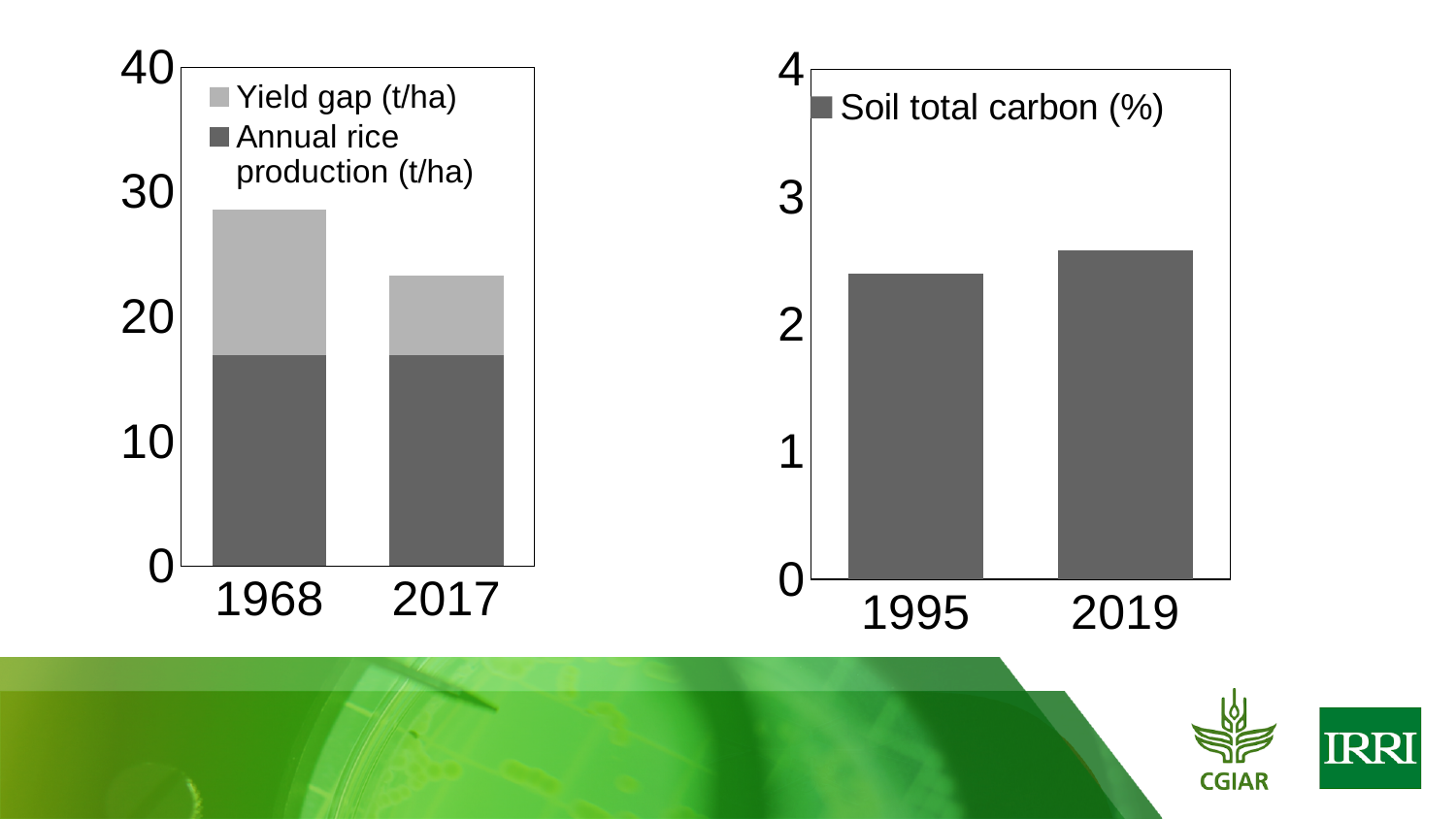
In the left chart, which year has the taller stacked bar, 1968 or 2017? 1968 In the left chart, is the total stacked value for 1968 greater or less than 20? greater How many series does the legend of the left chart list? 2 In the left chart, is the Yield gap (t/ha) segment for 2017 greater or less than 10? less In the right chart, does Soil total carbon (%) rise or fall from 1995 to 2019? rise What kind of chart is the left chart with the years 1968 and 2017? stacked bar chart What kind of chart is the right chart showing Soil total carbon (%)? bar chart In the left chart, which series is shown in the lighter grey colour? Yield gap (t/ha) How many categories are shown on the x axis of the right chart? 2 In the right chart, is the Soil total carbon (%) value for 1995 greater or less than 3? less In the right chart, which year has the higher Soil total carbon (%)? 2019